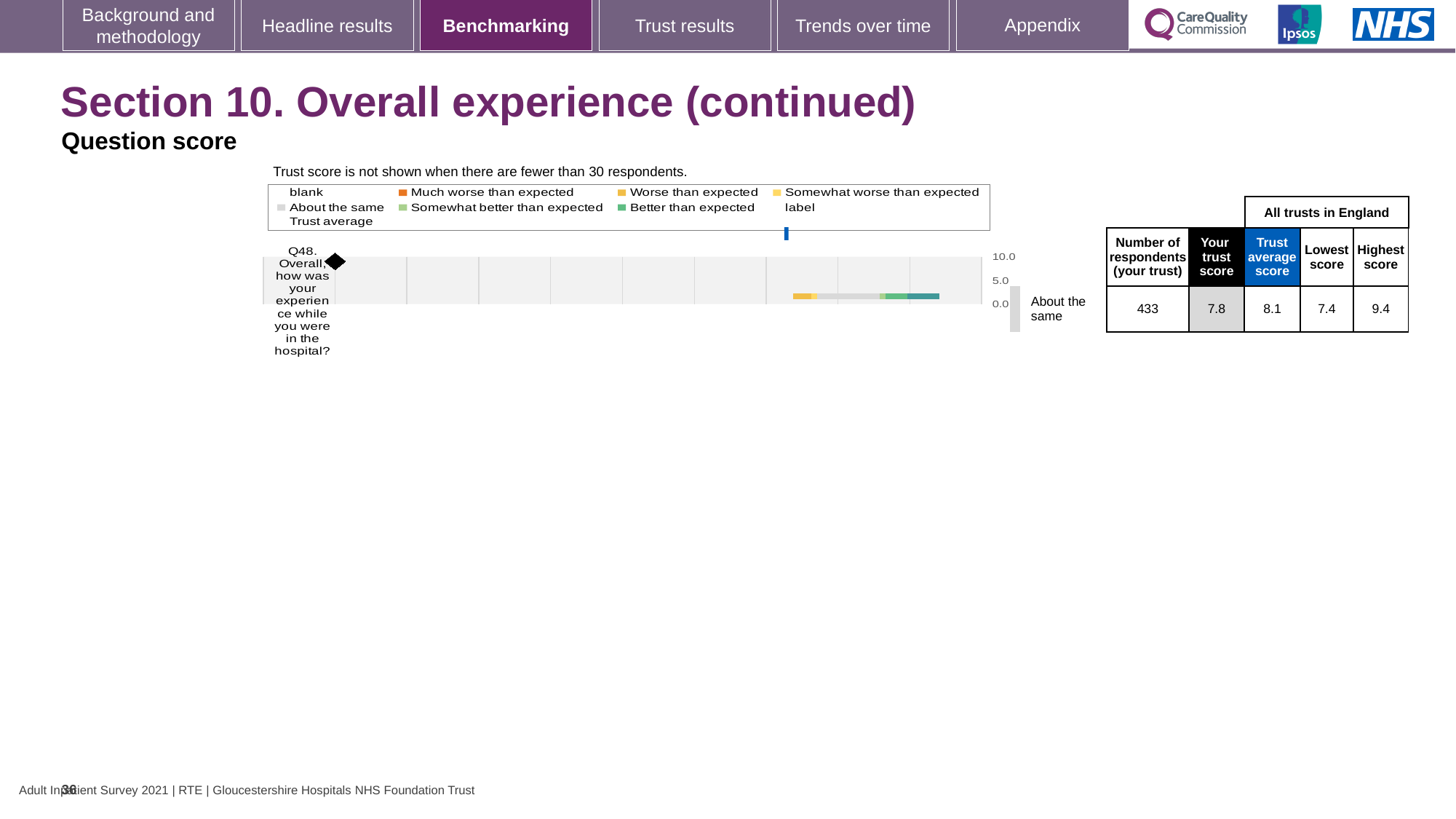
Is the trust score for Q48 greater or less than 5.0 on the chart axis? greater Which is larger for Q48: your trust score or the trust average score? Trust average score What is the difference between the trust average score and your trust score for Q48? 0.3 What is the highest score among all trusts in England for Q48? 9.4 What is the minimum number of respondents required for a trust score to be shown on the chart? 30 What is the trust average score across all trusts in England for Q48? 8.1 How is the trust's result for Q48 categorised relative to expectations? About the same How many respondents from the trust answered Q48? 433 How many questions are plotted on the benchmarking chart? 1 What is the trust score for Q48 (Overall, how was your experience while you were in the hospital?)? 7.8 What is the lowest score among all trusts in England for Q48? 7.4 What is the difference between the highest score and the lowest score for Q48 across all trusts in England? 2.0